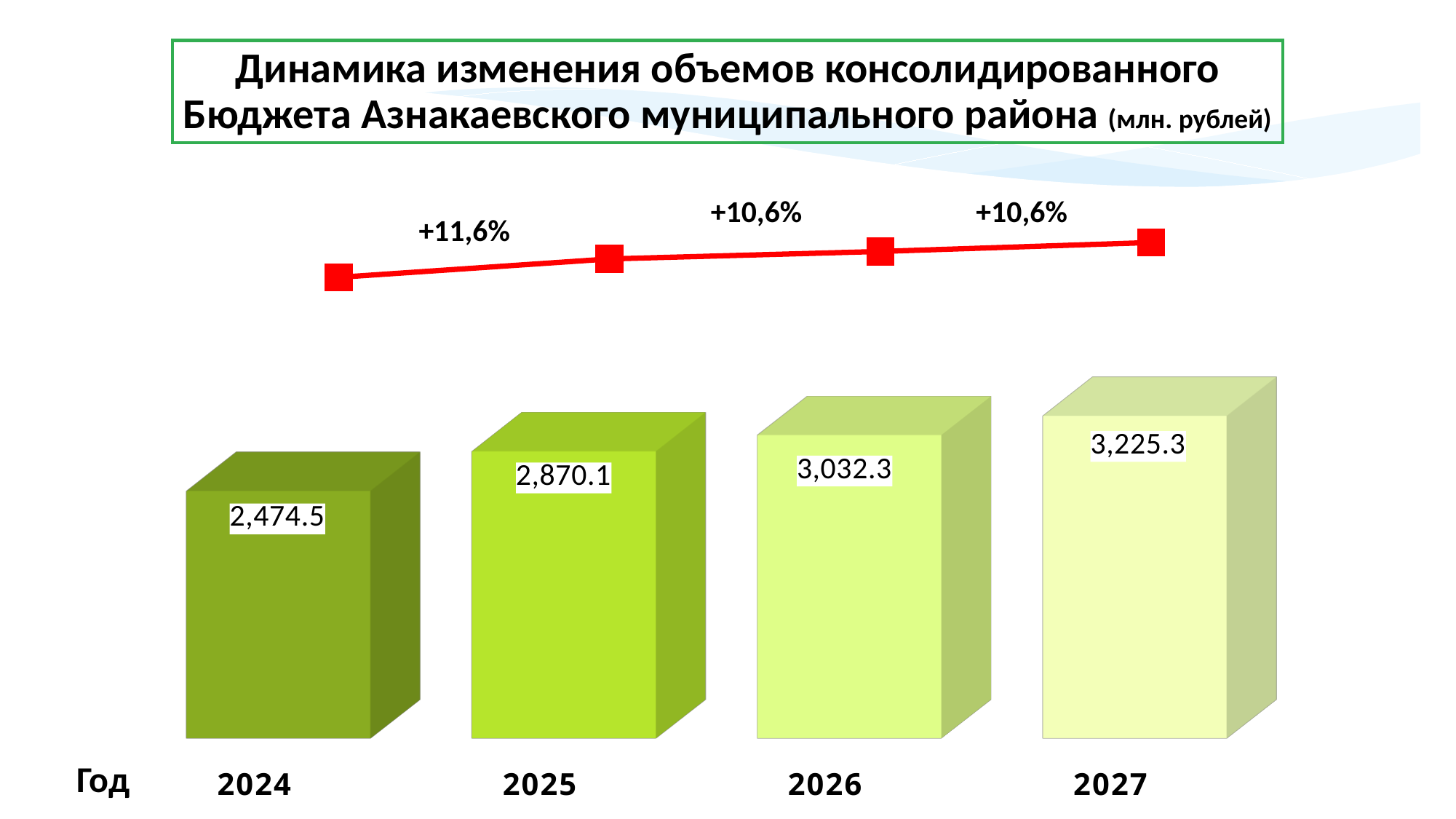
What percentage growth is labelled on the red line between 2024 and 2025? +11,6% What kind of chart is used to show the budget values? bar chart What is the consolidated budget value shown for 2026? 3,032.3 Which year has the highest budget value? 2027 What is the difference between the budget values for 2027 and 2026? 193.0 Which year has the lowest budget value? 2024 What is the consolidated budget value shown for 2024? 2,474.5 What is the consolidated budget value shown for 2027? 3,225.3 Which is larger, the budget value for 2026 or for 2025? 2026 What is the consolidated budget value shown for 2025? 2,870.1 What is the difference between the budget values for 2025 and 2024? 395.6 How many years are shown on the x axis? 4